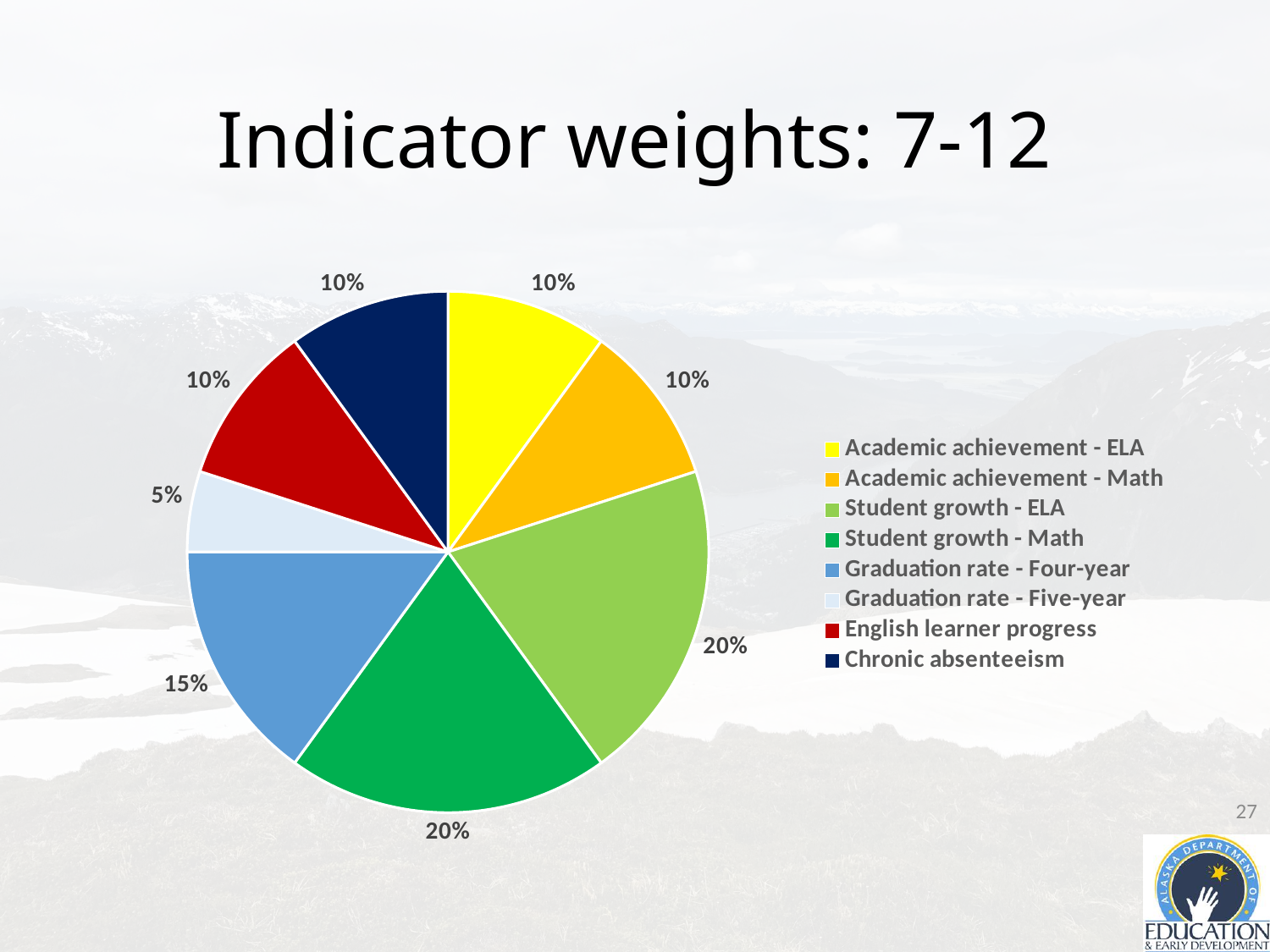
What is the weight for Graduation rate - Five-year? 5% What is the weight for Student growth - ELA? 20% What colour represents Chronic absenteeism in the chart? dark blue What is the difference between the weights for Student growth - Math and Graduation rate - Four-year? 5% What kind of chart is shown on the slide? pie chart Which has the larger weight, Graduation rate - Four-year or Academic achievement - Math? Graduation rate - Four-year What is the weight for Chronic absenteeism? 10% What is the title of the slide containing the chart? Indicator weights: 7-12 How many indicators are shown in the pie chart? 8 What is the weight for Graduation rate - Four-year? 15% What is the weight for English learner progress? 10% Which indicator has the smallest weight? Graduation rate - Five-year